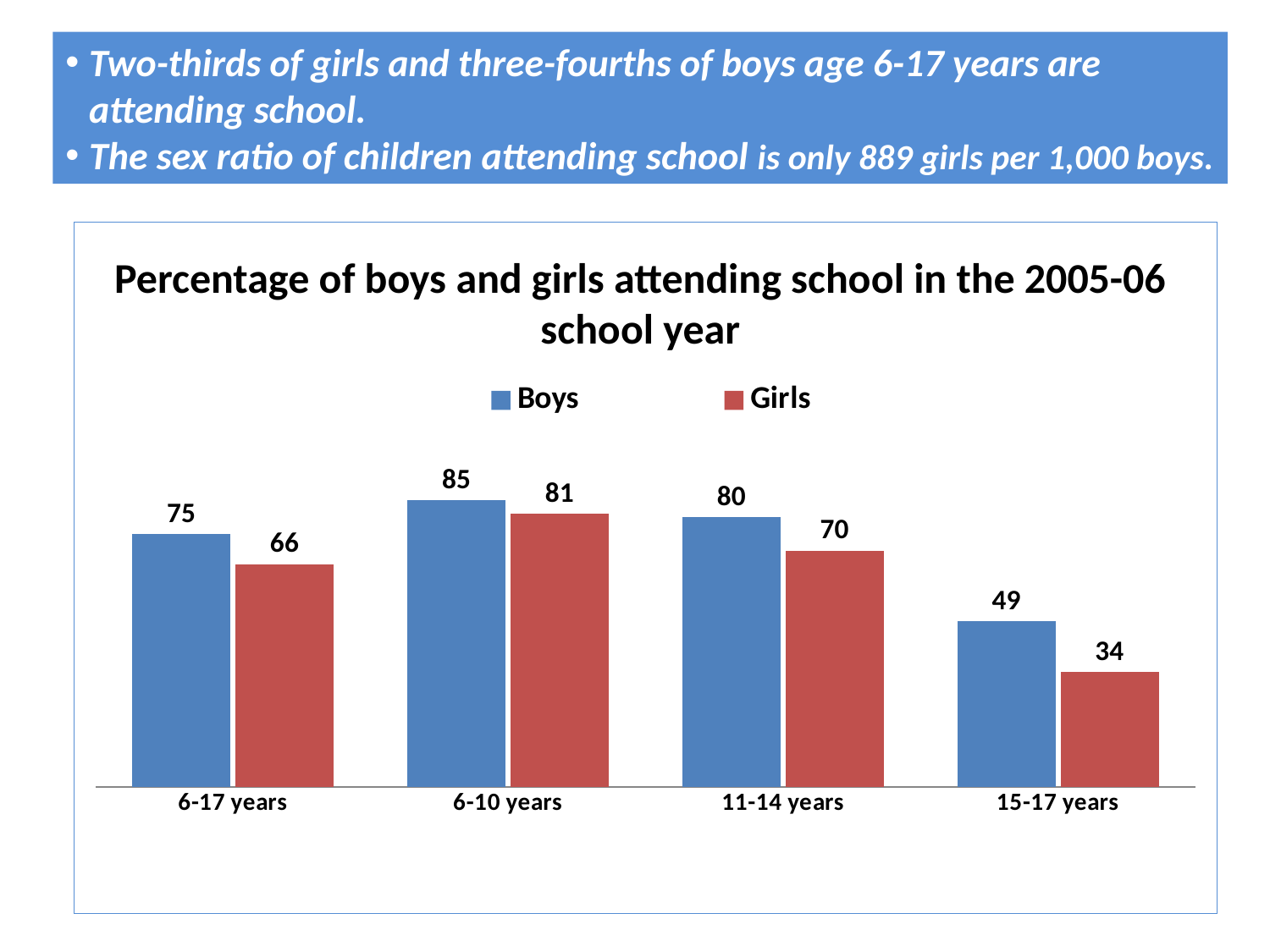
Which is larger, the Girls value for 6-10 years or the Girls value for 11-14 years? 6-10 years What is the difference between the Boys and Girls values for 15-17 years? 15 What colour are the Girls bars? Red How many series does the legend list? 2 Which age group has the lowest value for Girls? 15-17 years How many age group categories are shown on the x axis? 4 What kind of chart is shown on the slide? Bar chart What percentage of boys age 6-17 years are attending school? 75 Which age group has the highest value for Boys? 6-10 years What is the value for Girls in the 15-17 years category? 34 What is the value for Girls in the 11-14 years category? 70 What is the difference between the Boys values for 6-10 years and 11-14 years? 5